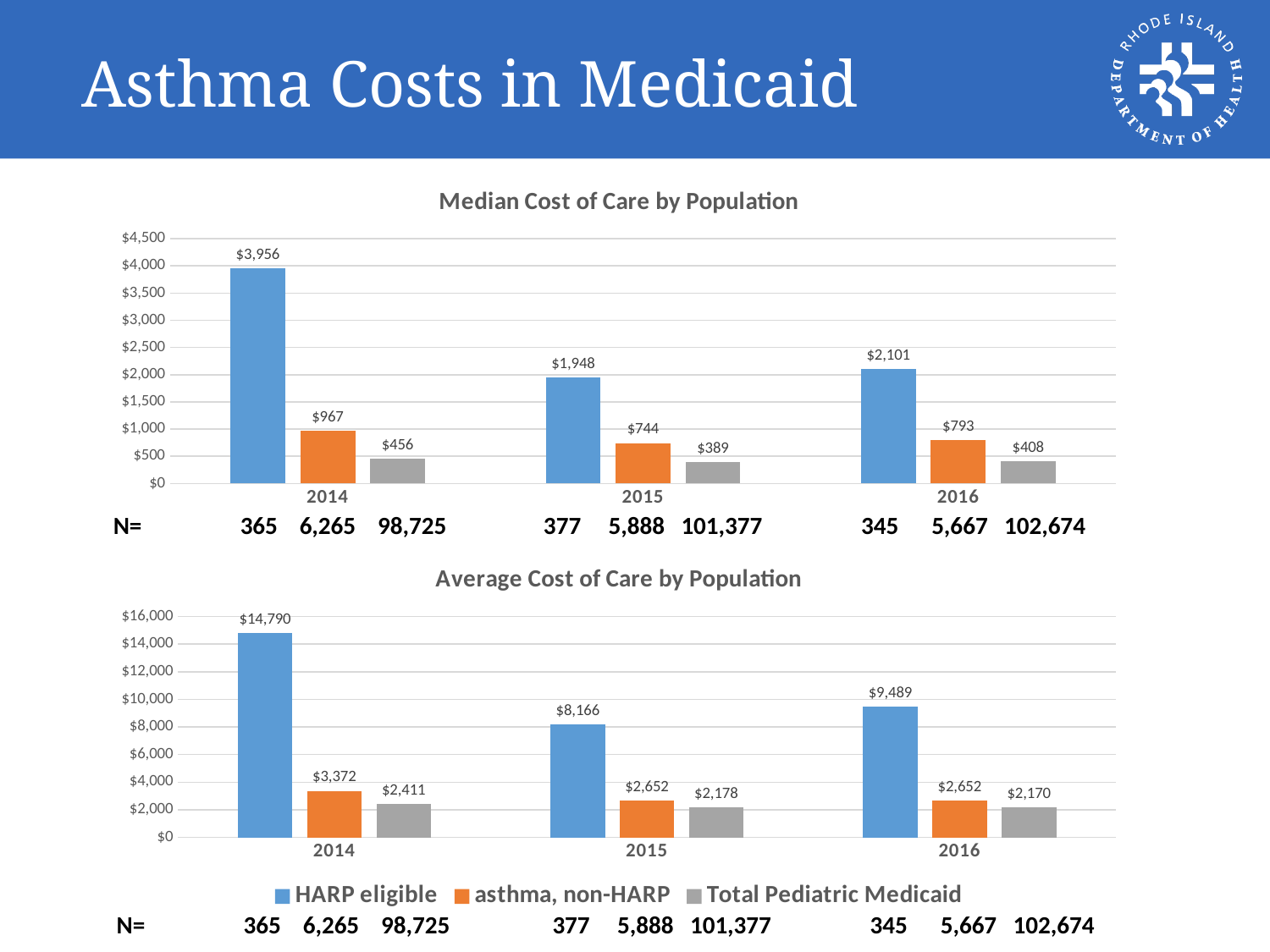
In the 'Median Cost of Care by Population' chart, is the HARP eligible median cost in 2015 greater or less than $2,000? less In the 'Average Cost of Care by Population' chart, what is the average cost for Total Pediatric Medicaid in 2016? $2,170 In the 'Average Cost of Care by Population' chart, what is the difference between the HARP eligible average cost in 2014 and in 2015? $6,624 In the 'Median Cost of Care by Population' chart, how many years are shown on the x axis? 3 How many series does the legend list? 3 In the 'Average Cost of Care by Population' chart, which year has the highest average cost for HARP eligible? 2014 In the 'Median Cost of Care by Population' chart, what is the median cost for asthma, non-HARP in 2015? $744 What kind of chart is the 'Average Cost of Care by Population' chart? bar chart In the 'Median Cost of Care by Population' chart, what is the median cost for HARP eligible in 2014? $3,956 In the 'Median Cost of Care by Population' chart, what is the difference between the HARP eligible and asthma, non-HARP median costs in 2016? $1,308 In the 'Average Cost of Care by Population' chart, is the average cost for asthma, non-HARP larger in 2014 or in 2016? 2014 In the 'Median Cost of Care by Population' chart, which year has the lowest median cost for Total Pediatric Medicaid? 2015